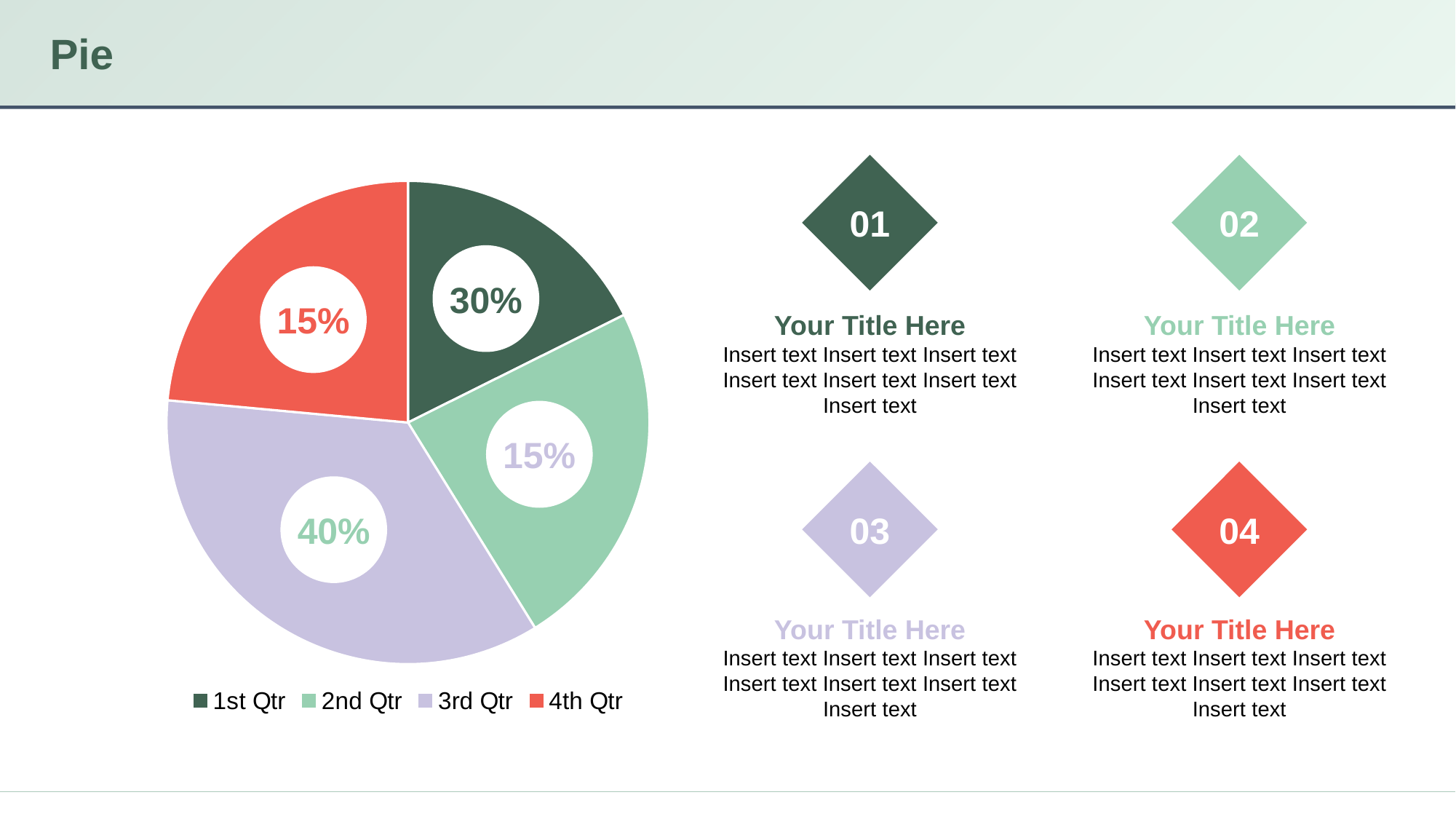
What is the value shown for 1st Qtr in the pie chart? 30% What share of the pie does 3rd Qtr represent? 40% What kind of chart is shown on the slide? pie chart What is the difference between the 3rd Qtr and 1st Qtr values in the pie chart? 10% What is the value shown for 2nd Qtr in the pie chart? 15% How many slices does the pie chart have? 4 What colour is the 4th Qtr slice in the pie chart? red How many entries does the legend of the pie chart list? 4 Which category has the largest slice in the pie chart? 3rd Qtr What is the value shown for 4th Qtr in the pie chart? 15% What is the value shown for 3rd Qtr in the pie chart? 40%